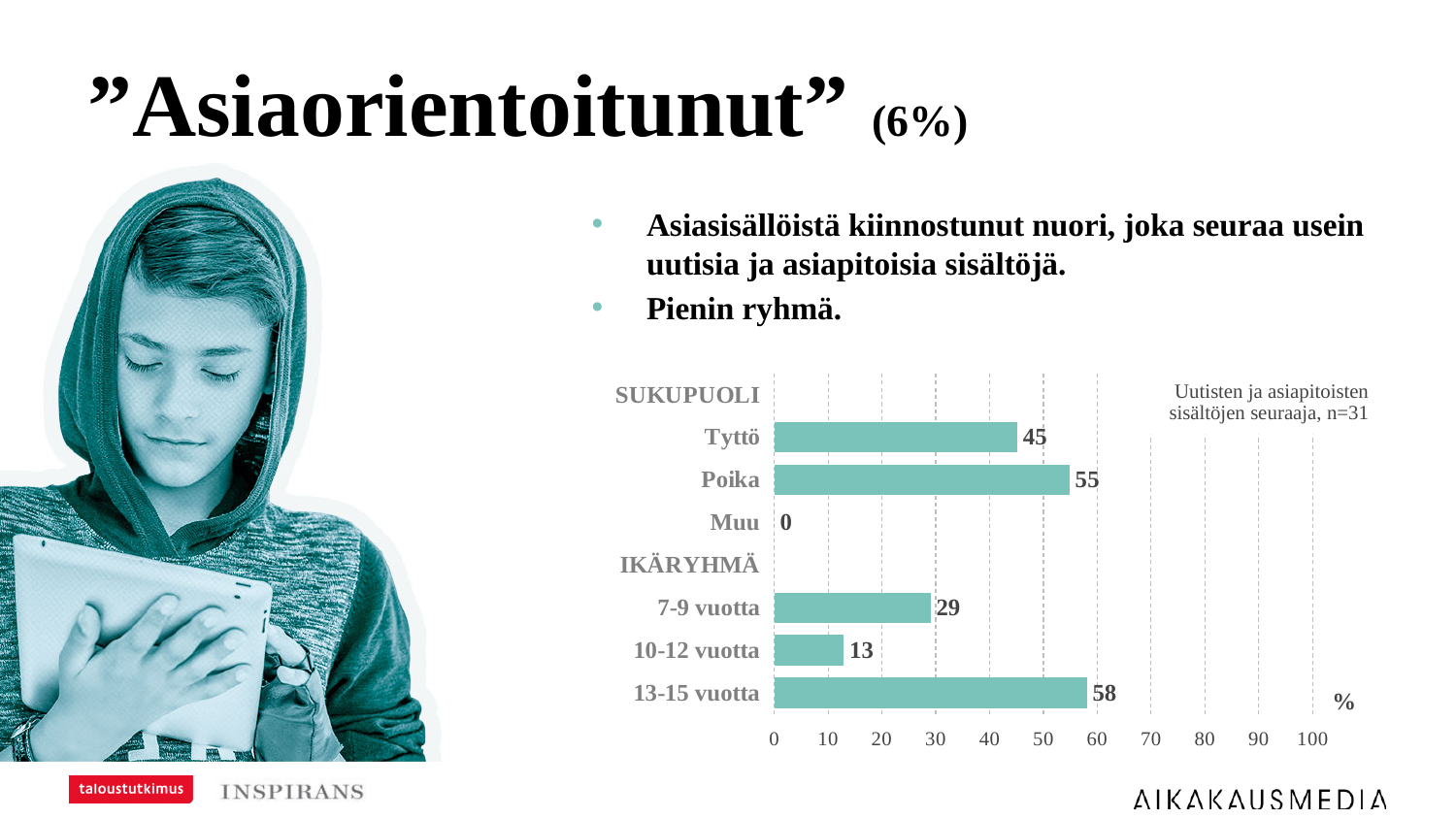
Which is larger, the value for 7-9 vuotta or the value for 10-12 vuotta? 7-9 vuotta How many categories are plotted in the chart? 6 What kind of chart is shown on the slide? bar chart Which category has the highest value? 13-15 vuotta What is the difference between the values for Poika and Tyttö? 10 What is the value for 10-12 vuotta? 13 What is the sample size (n) stated in the chart's annotation? n=31 What is the value for 13-15 vuotta? 58 Which age group (ikäryhmä) has the lowest value? 10-12 vuotta What is the value for Poika? 55 What is the value for Tyttö? 45 Is the value for 13-15 vuotta greater or less than 50? greater